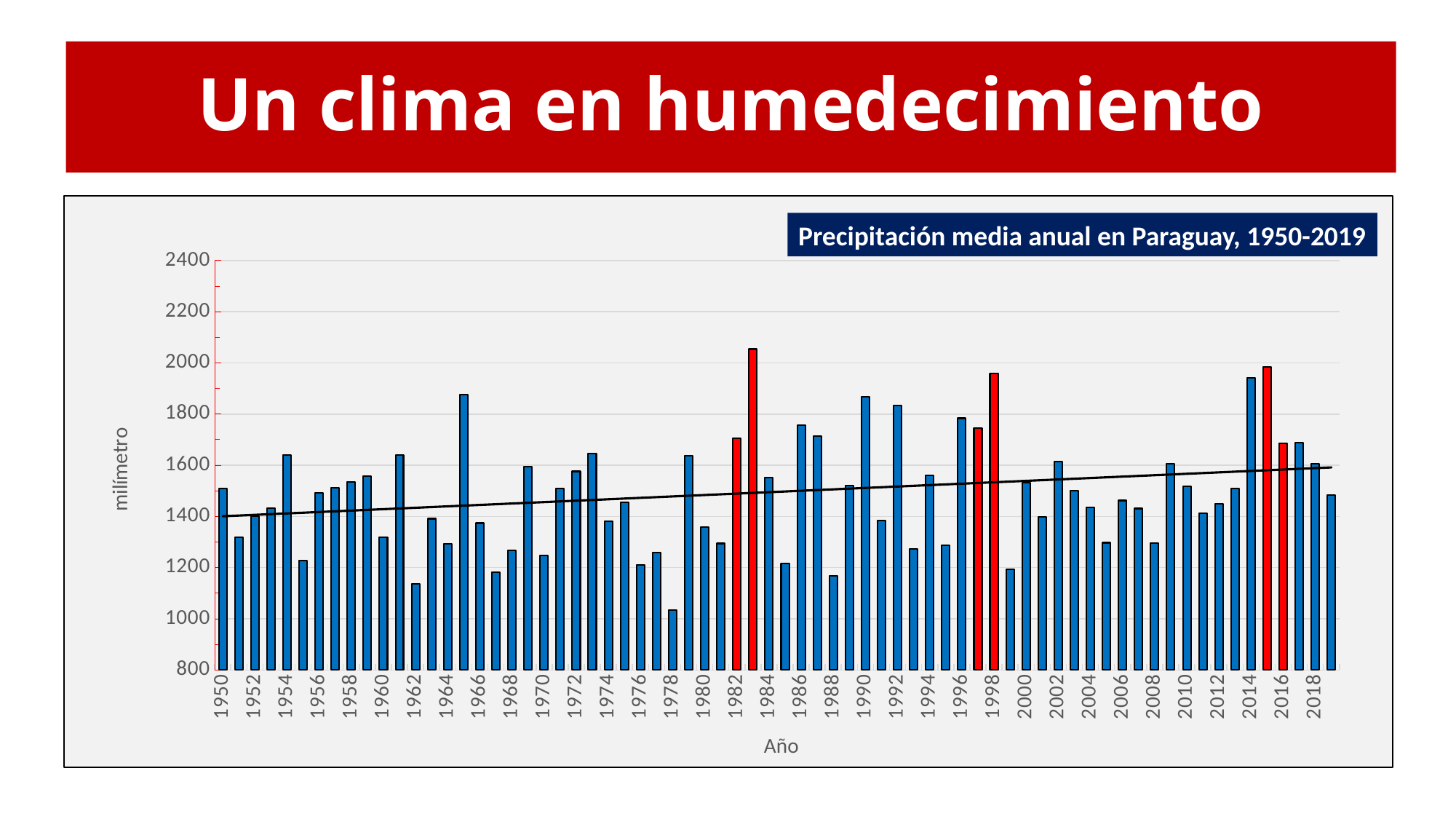
Does the trend line show precipitation rising or falling from 1950 to 2019? rising Is the value for 1962 greater or less than 1200? less What is the title of the chart? Precipitación media anual en Paraguay, 1950-2019 Which year has the larger value, 1983 or 1998? 1983 Which year has the lowest precipitation value? 1978 Is the value for 1965 greater or less than 1800? greater Is the value for 1978 greater or less than 1200? less Which year has the larger value, 1965 or 1978? 1965 Which year has the highest precipitation value? 1983 What is the label of the vertical axis? milímetro What kind of chart is shown on the slide? bar chart